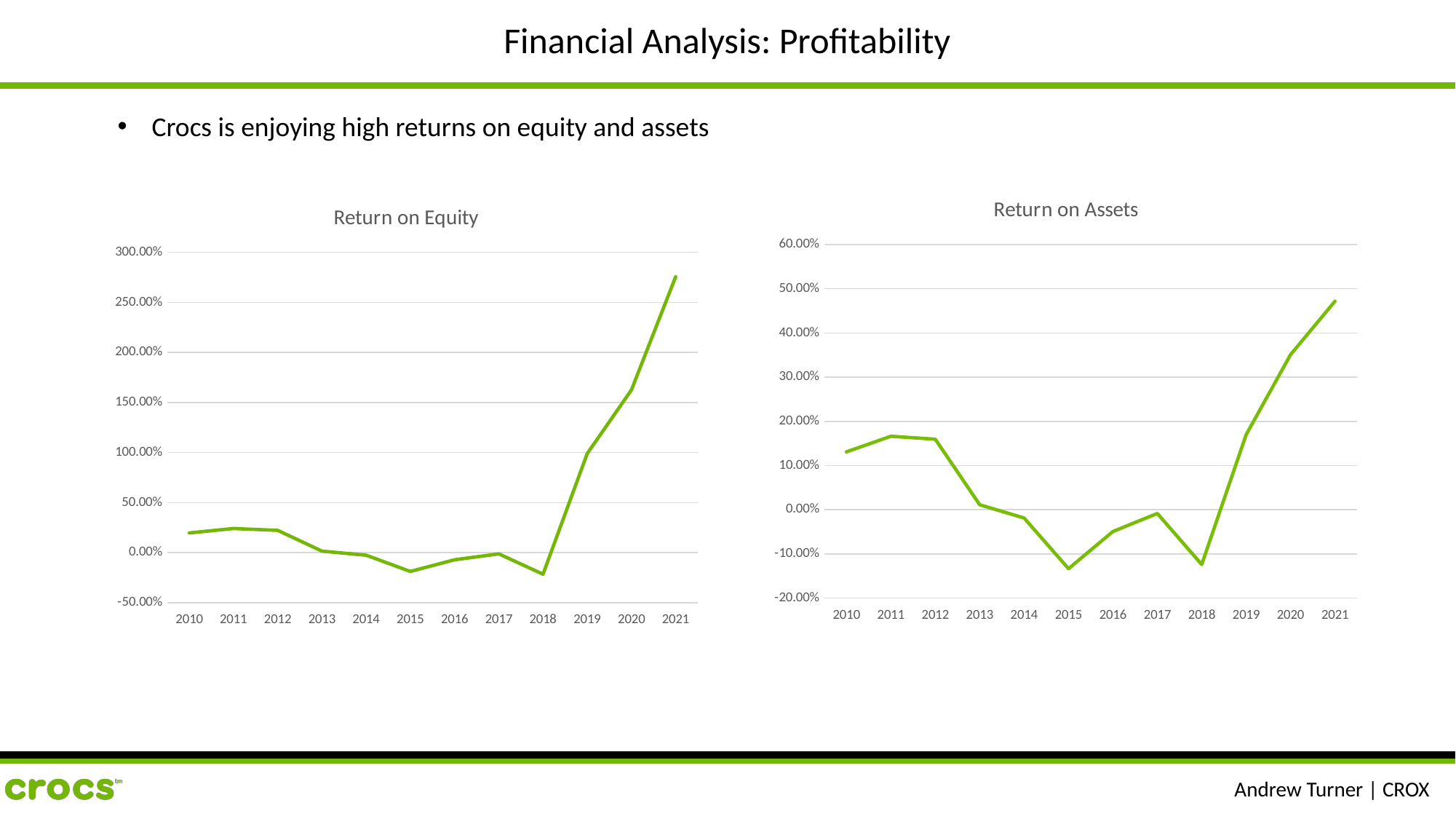
On the Return on Assets chart, which year has the highest value? 2021 On the Return on Equity chart, is the value for 2020 greater or less than 150.00%? greater On the Return on Assets chart, is the value for 2021 greater or less than 50.00%? less On the Return on Equity chart, which year has the highest value? 2021 On the Return on Assets chart, which is larger, the value for 2020 or the value for 2012? 2020 What kind of chart is the Return on Equity chart? line chart On the Return on Equity chart, which is larger, the value for 2019 or the value for 2010? 2019 On the Return on Equity chart, do the values rise or fall from 2018 to 2021? rise On the Return on Equity chart, is the value for 2021 greater or less than 250.00%? greater How many years are plotted on the Return on Assets chart? 12 What is the title of the chart on the right side of the slide? Return on Assets